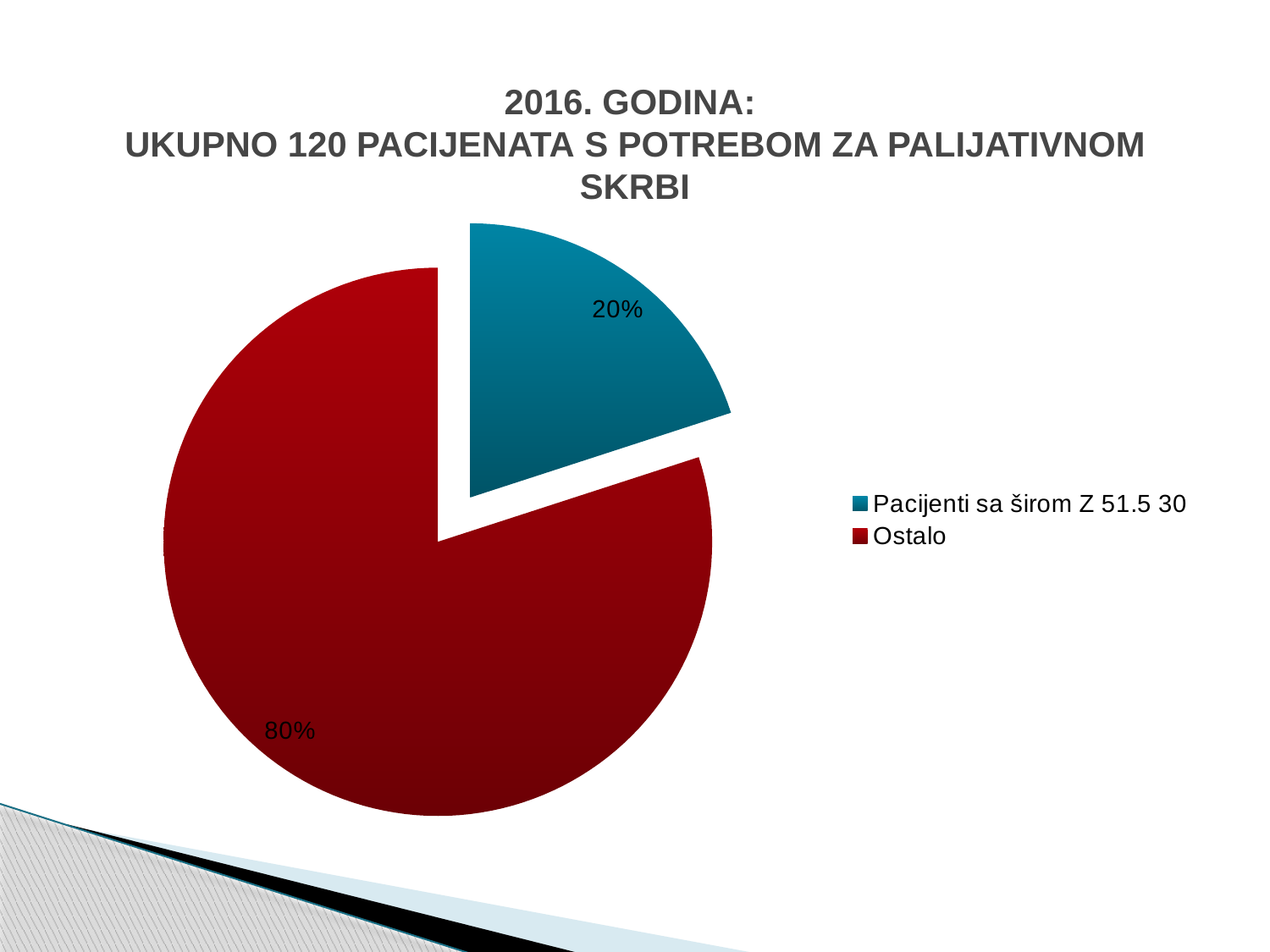
Which is larger, the 'Ostalo' slice or the 'Pacijenti sa širom Z 51.5 30' slice? Ostalo What kind of chart is shown on the slide? pie chart What colour is the 'Ostalo' slice? red What is the difference in percentage points between the 'Ostalo' slice and the 'Pacijenti sa širom Z 51.5 30' slice? 60 percentage points Which slice of the pie is the largest? Ostalo What share of the pie does the 'Ostalo' slice represent? 80% Which slice of the pie is the smallest? Pacijenti sa širom Z 51.5 30 How many entries does the legend list? 2 According to the chart title, how many patients in total needed palliative care in 2016? 120 What colour is the 'Pacijenti sa širom Z 51.5 30' slice? blue What share of the pie does the 'Pacijenti sa širom Z 51.5 30' slice represent? 20% How many slices does the pie chart have? 2